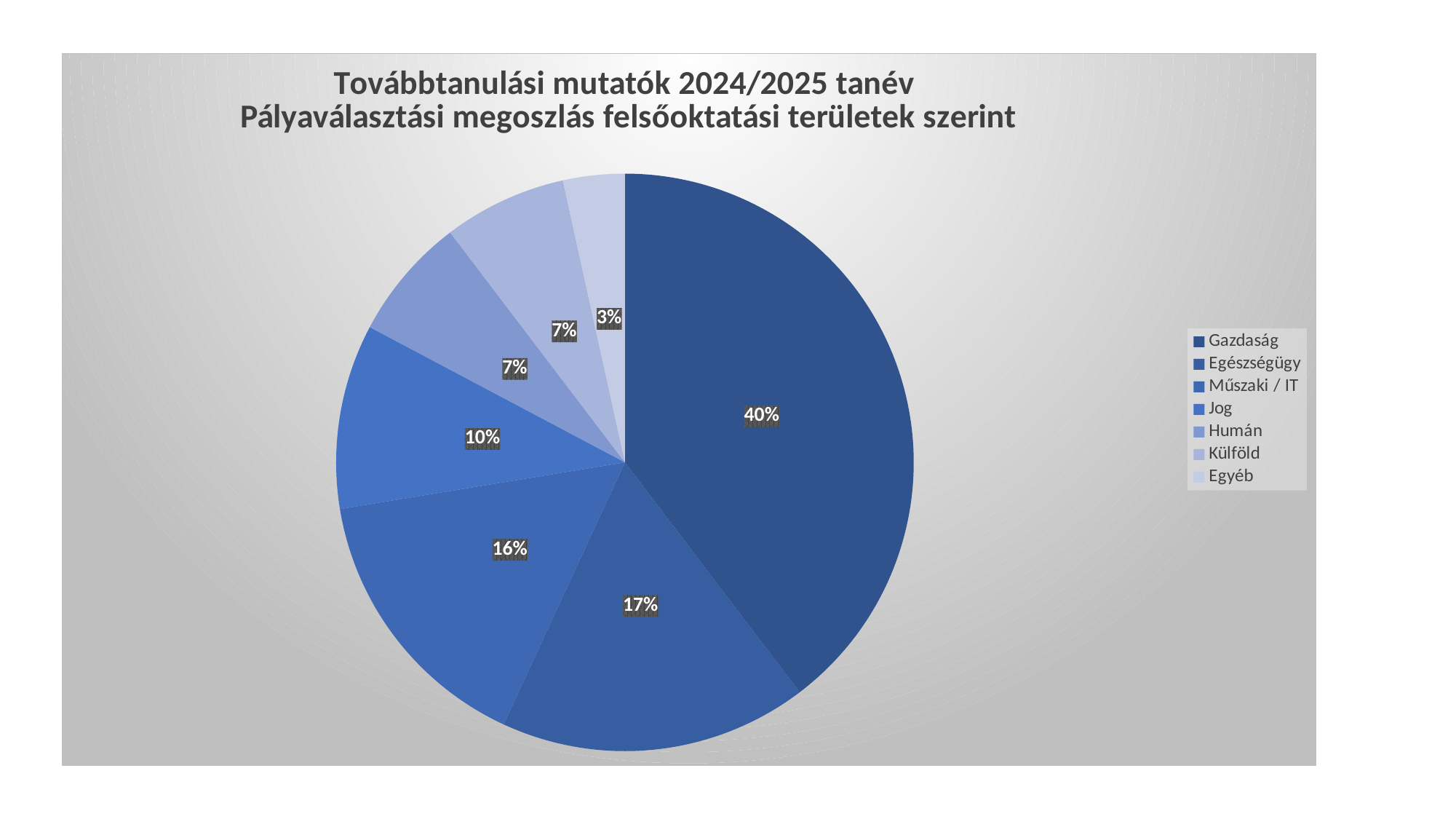
What kind of chart is shown on the slide? pie chart What is the difference in percentage points between Gazdaság and Egészségügy? 23 What is the first line of the chart title? Továbbtanulási mutatók 2024/2025 tanév What share of the pie does Műszaki / IT have? 16% Which category has the largest slice of the pie? Gazdaság Which category has the smallest slice of the pie? Egyéb Which is larger, the slice for Jog or the slice for Humán? Jog How many categories does the legend list? 7 What share of the pie does Egészségügy have? 17% What share of the pie does Gazdaság have? 40% What share of the pie does Egyéb have? 3% What share of the pie does Jog have? 10%